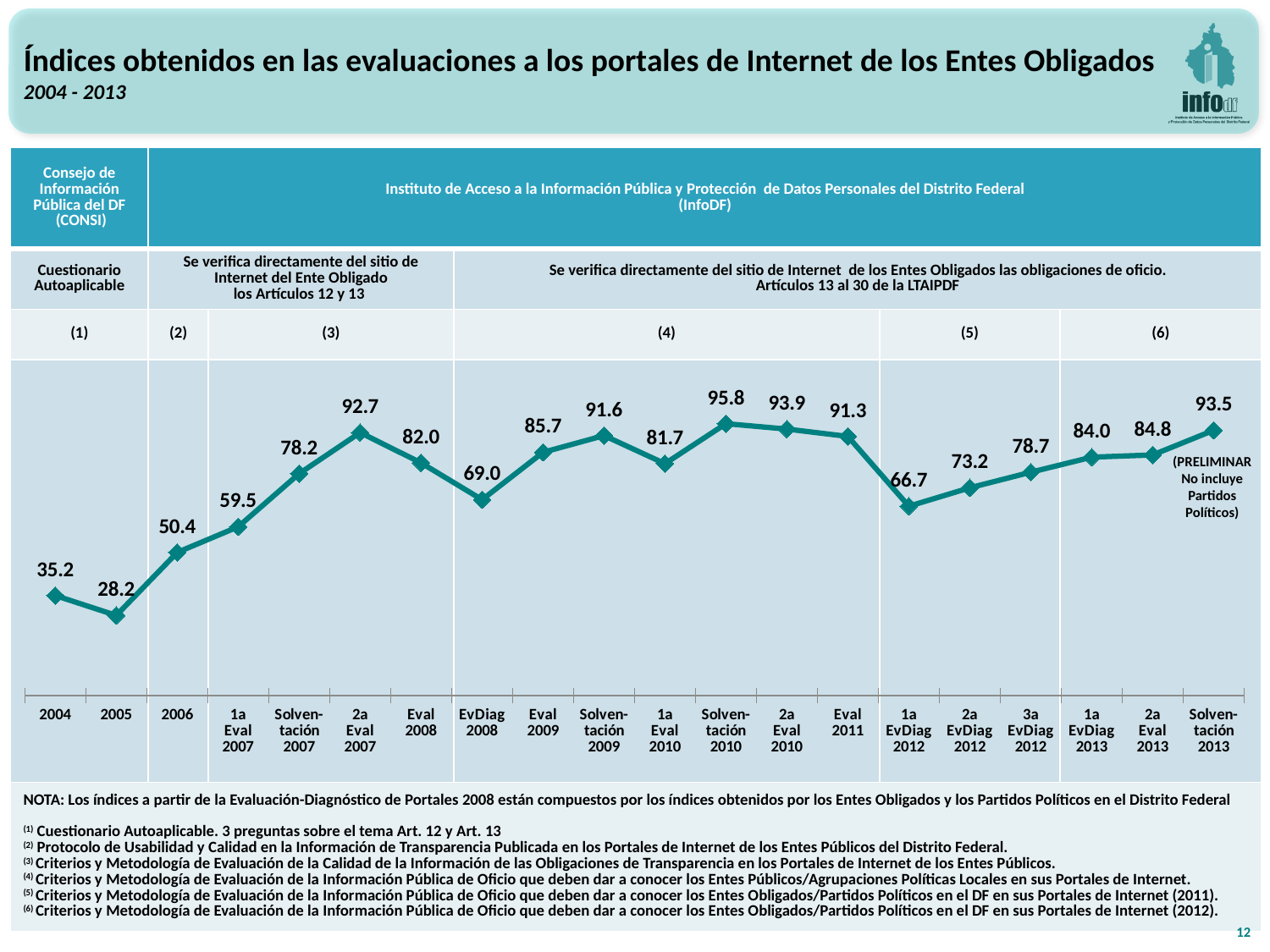
Which is larger, the value for Eval 2009 or the value for 1a Eval 2010? Eval 2009 How many data points are plotted on the chart? 20 Which point on the chart has the highest value? Solventación 2010 What is the value for 2004? 35.2 What is the value for Solventación 2010? 95.8 What is the value for Solventación 2013? 93.5 What kind of chart is shown on the slide? Line chart Do the values rise or fall from 1a EvDiag 2012 to Solventación 2013? Rise What is the difference between the values for 2006 and 2005? 22.2 Which point on the chart has the lowest value? 2005 What is the difference between the values for 2a Eval 2007 and Eval 2008? 10.7 What is the value for 1a EvDiag 2012? 66.7